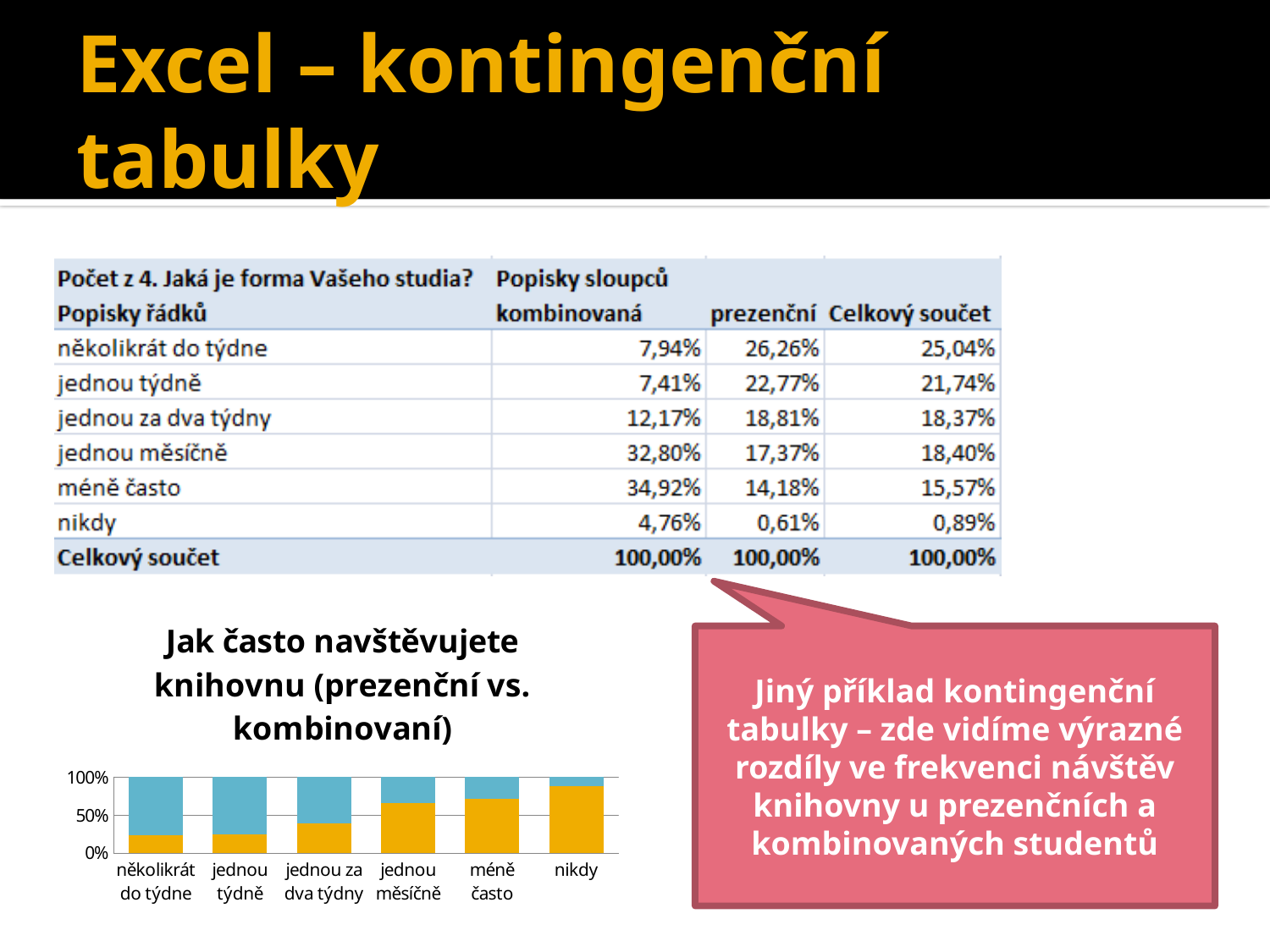
In the chart, is the orange segment for 'méně často' greater or less than 50%? greater What does each stacked bar in the chart total? 100% In the chart, is the orange segment for 'nikdy' greater or less than 50%? greater In the chart, is the orange segment for 'jednou za dva týdny' greater or less than 50%? less What is the title of the chart on the slide? Jak často navštěvujete knihovnu (prezenční vs. kombinovaní) Which category in the chart has the largest orange segment? nikdy Does the orange share of each bar rise or fall moving from left to right along the x axis of the chart? rise What is the highest value shown on the y axis of the chart? 100% How many categories are shown on the x axis of the chart? 6 What kind of chart is shown at the bottom left of the slide? bar chart